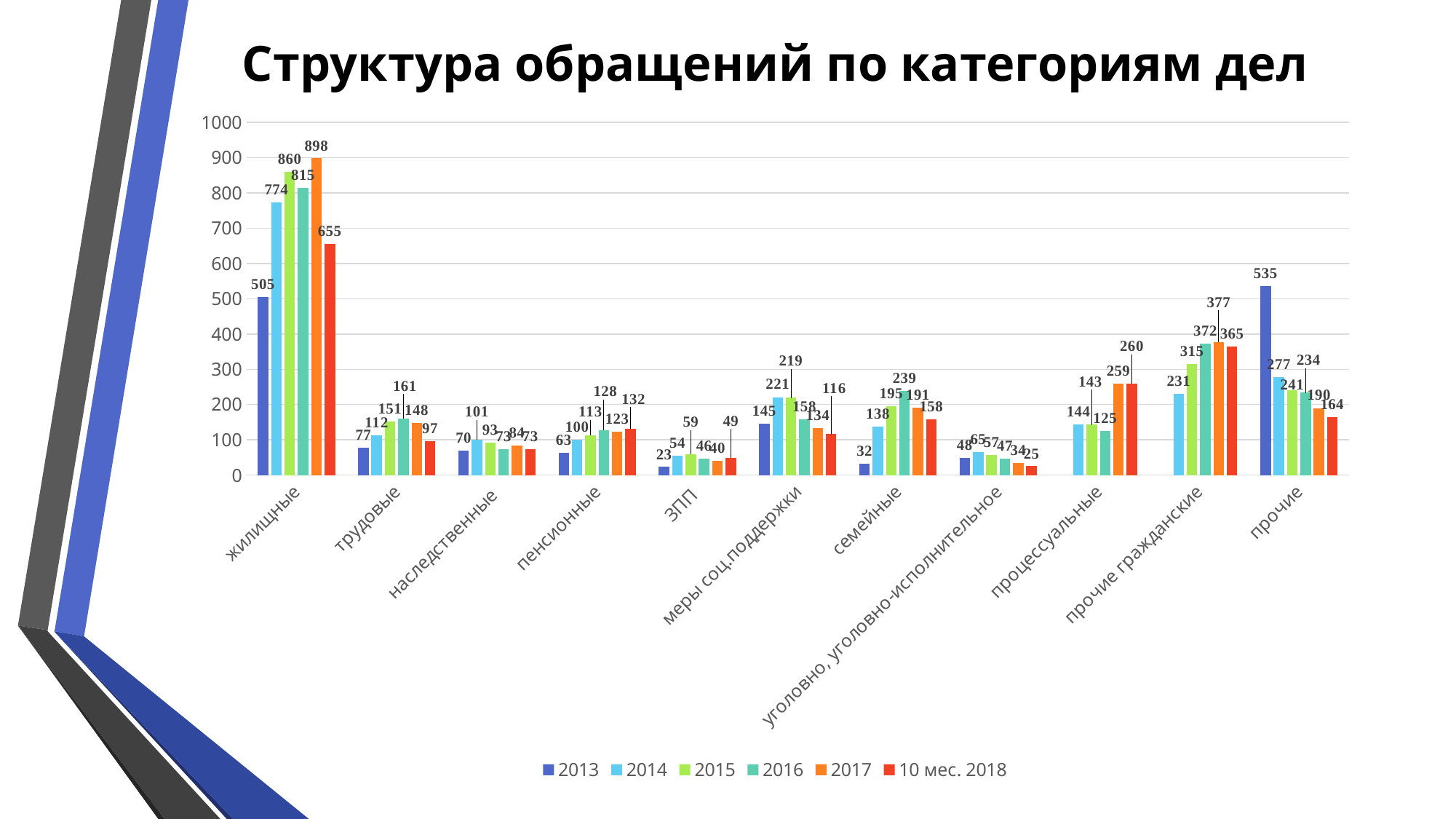
Which category has the highest value in 2015? жилищные Do the values for прочие rise or fall from 2013 to 10 мес. 2018? fall Which category has the lowest value in 2013? ЗПП What is the difference between the 2017 and 2013 values for жилищные? 393 What is the title of the chart? Структура обращений по категориям дел What is the value for жилищные in 2017? 898 What is the value for семейные in 2016? 239 What kind of chart is shown on the slide? bar chart Which is larger: the 2014 value for меры соц.поддержки or the 2014 value for семейные? меры соц.поддержки How many series does the legend list? 6 What is the value for прочие in 2013? 535 How many categories are shown on the x axis? 11